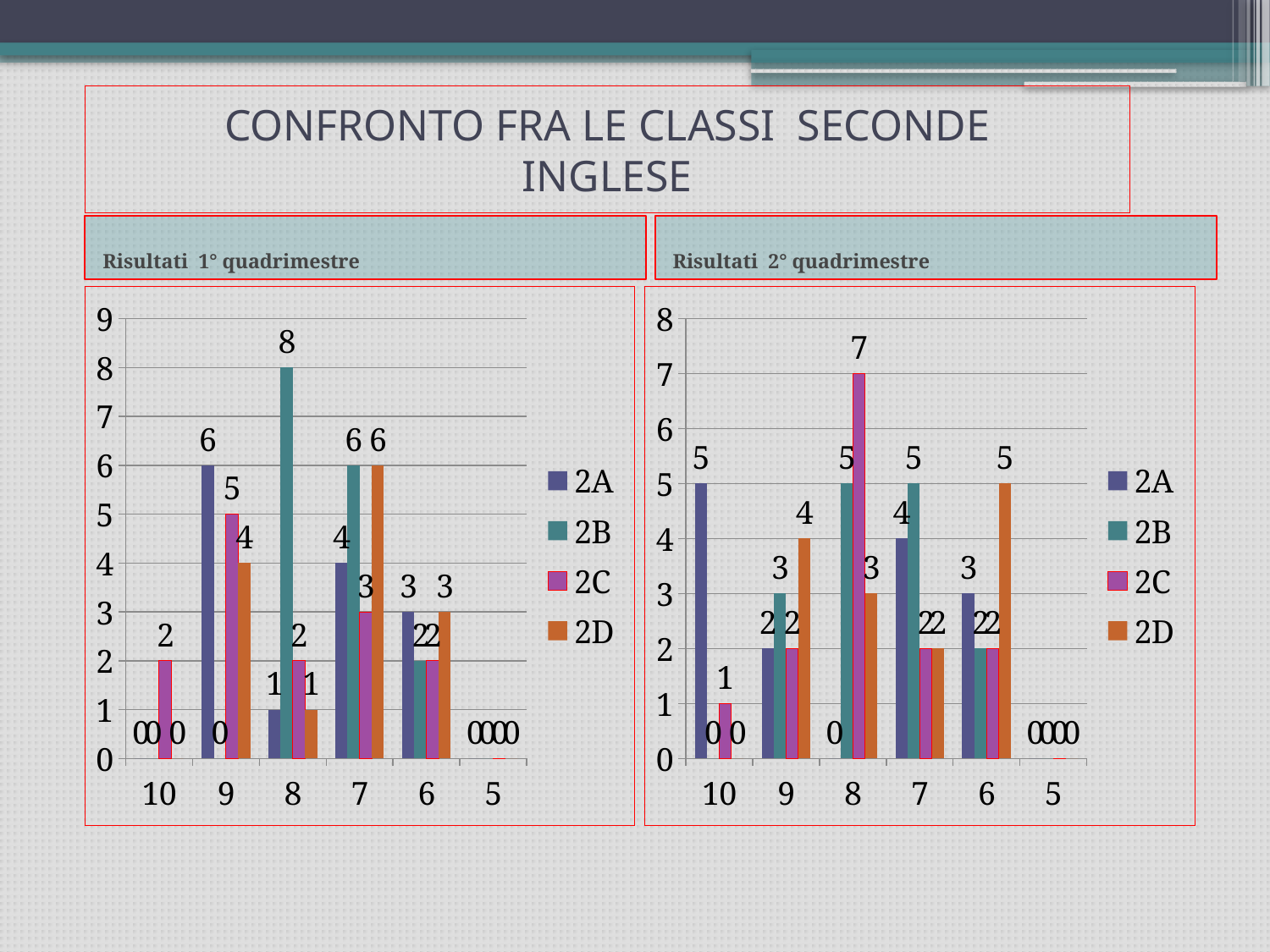
In the 'Risultati 1° quadrimestre' chart, how many categories are shown on the x axis? 6 What type of chart is the 'Risultati 1° quadrimestre' chart? Bar chart In the 'Risultati 2° quadrimestre' chart, what is the value for 2A at category 10? 5 In the 'Risultati 1° quadrimestre' chart, what is the difference between 2B and 2C at category 8? 6 In the 'Risultati 2° quadrimestre' chart, what is the difference between 2D and 2A at category 9? 2 In the 'Risultati 2° quadrimestre' chart, which series has the lowest value at category 8? 2A In the 'Risultati 2° quadrimestre' chart, is the value for 2D at category 6 larger than the value for 2A at category 6? Yes In the 'Risultati 2° quadrimestre' chart, what is the value for 2C at category 8? 7 How many series does the legend of the 'Risultati 2° quadrimestre' chart list? 4 In the 'Risultati 1° quadrimestre' chart, what is the value for 2A at category 9? 6 In the 'Risultati 1° quadrimestre' chart, what is the value for 2B at category 8? 8 In the 'Risultati 1° quadrimestre' chart, which series has the highest value at category 7? 2B and 2D